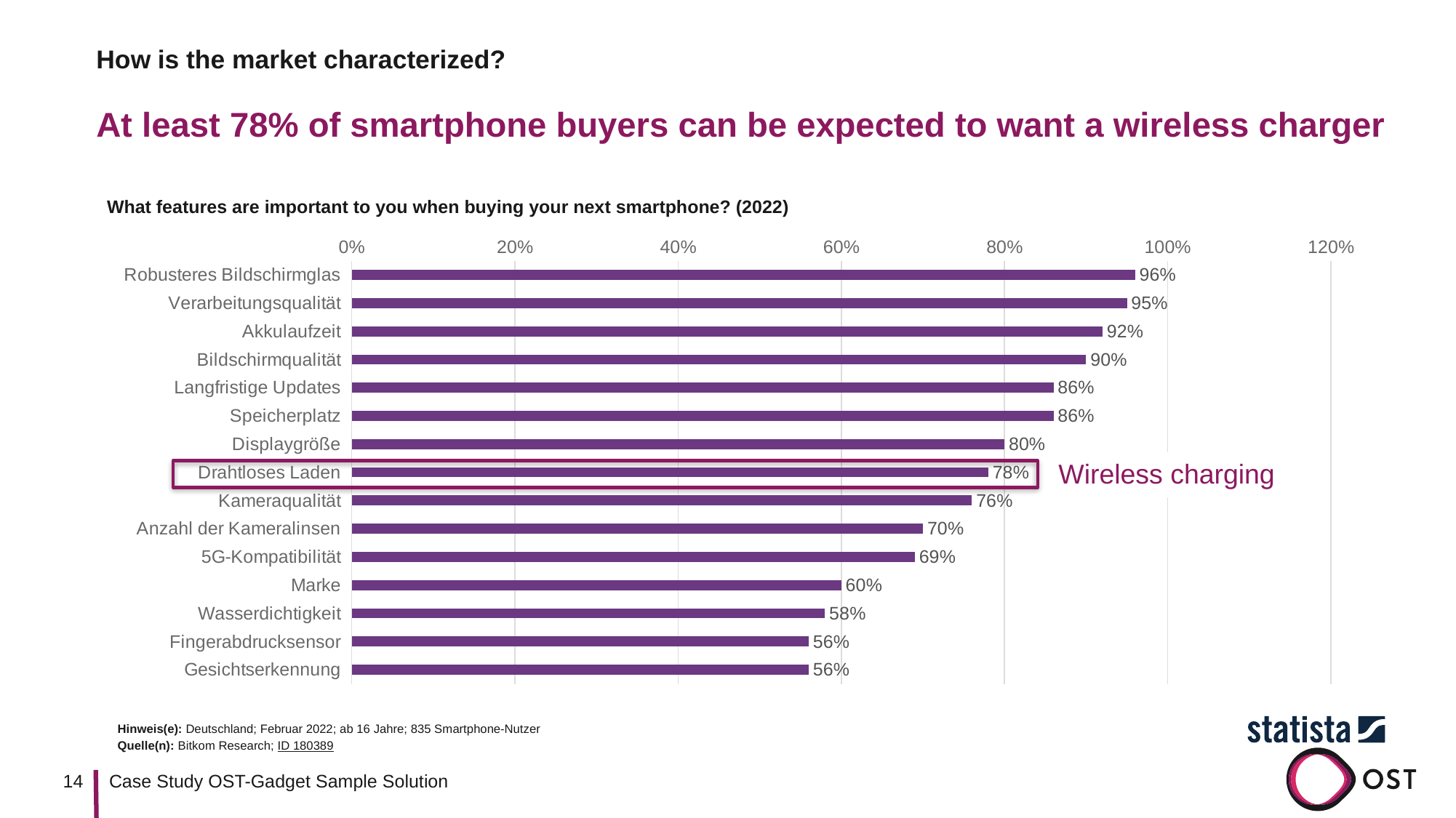
What is the difference in percentage points between Anzahl der Kameralinsen and 5G-Kompatibilität? 1 Which feature is highlighted with a box and annotated as 'Wireless charging'? Drahtloses Laden What is the title of the chart? What features are important to you when buying your next smartphone? (2022) How many features are listed in the chart? 15 What is the value shown for Marke? 60% What is the difference in percentage points between Robusteres Bildschirmglas and Drahtloses Laden? 18 What is the value shown for Akkulaufzeit? 92% Which feature has the highest percentage in the chart? Robusteres Bildschirmglas What type of chart is shown on the slide? Bar chart What percentage of respondents consider Drahtloses Laden important when buying their next smartphone? 78% Is the value for Wasserdichtigkeit greater or less than 60%? less Which has a higher value, Displaygröße or Kameraqualität? Displaygröße